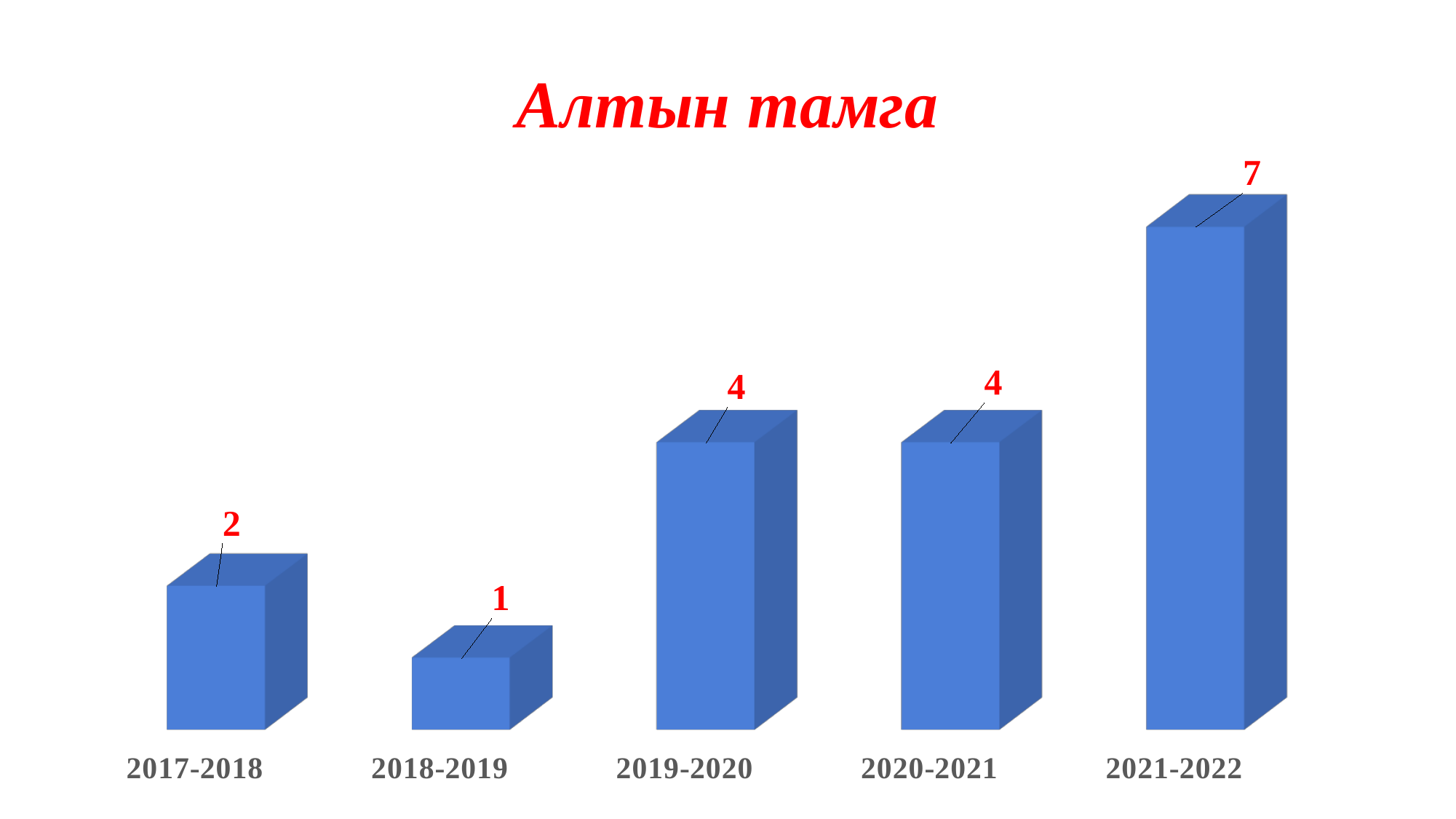
What is the title of the chart? Алтын тамга Which category has the highest value? 2021-2022 What is the difference between the values for 2017-2018 and 2018-2019? 1 What is the value for 2017-2018? 2 What is the value for 2018-2019? 1 Which category has the lowest value? 2018-2019 What kind of chart is shown on the slide? bar chart What is the value for 2021-2022? 7 What is the difference between the values for 2021-2022 and 2020-2021? 3 How many categories are shown on the x axis? 5 What is the value for 2019-2020? 4 Which is larger, the value for 2019-2020 or the value for 2017-2018? 2019-2020